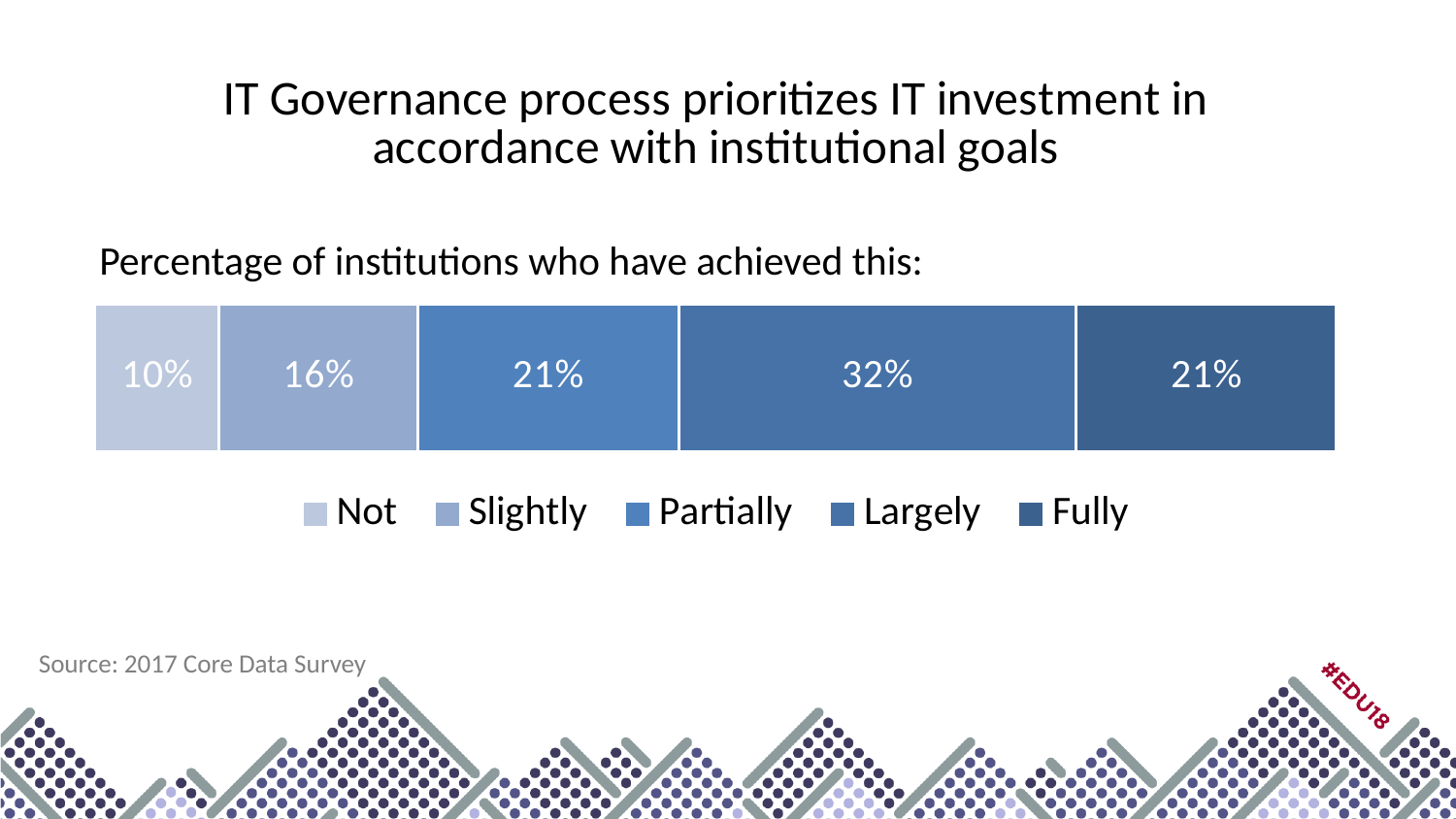
What kind of chart is shown on the slide? Stacked bar chart What percentage of institutions are in the "Not" category? 10% What percentage of institutions are in the "Slightly" category? 16% How many series does the legend list? 5 What is the source cited for the chart data? 2017 Core Data Survey Which category has the smallest share of institutions? Not What percentage of institutions are in the "Largely" category? 32% What is the total of all segments in the stacked bar? 100% What percentage of institutions are in the "Fully" category? 21% Which category has the largest share of institutions? Largely Which is larger, the "Slightly" share or the "Partially" share? Partially What is the difference between the "Largely" and "Fully" percentages? 11%